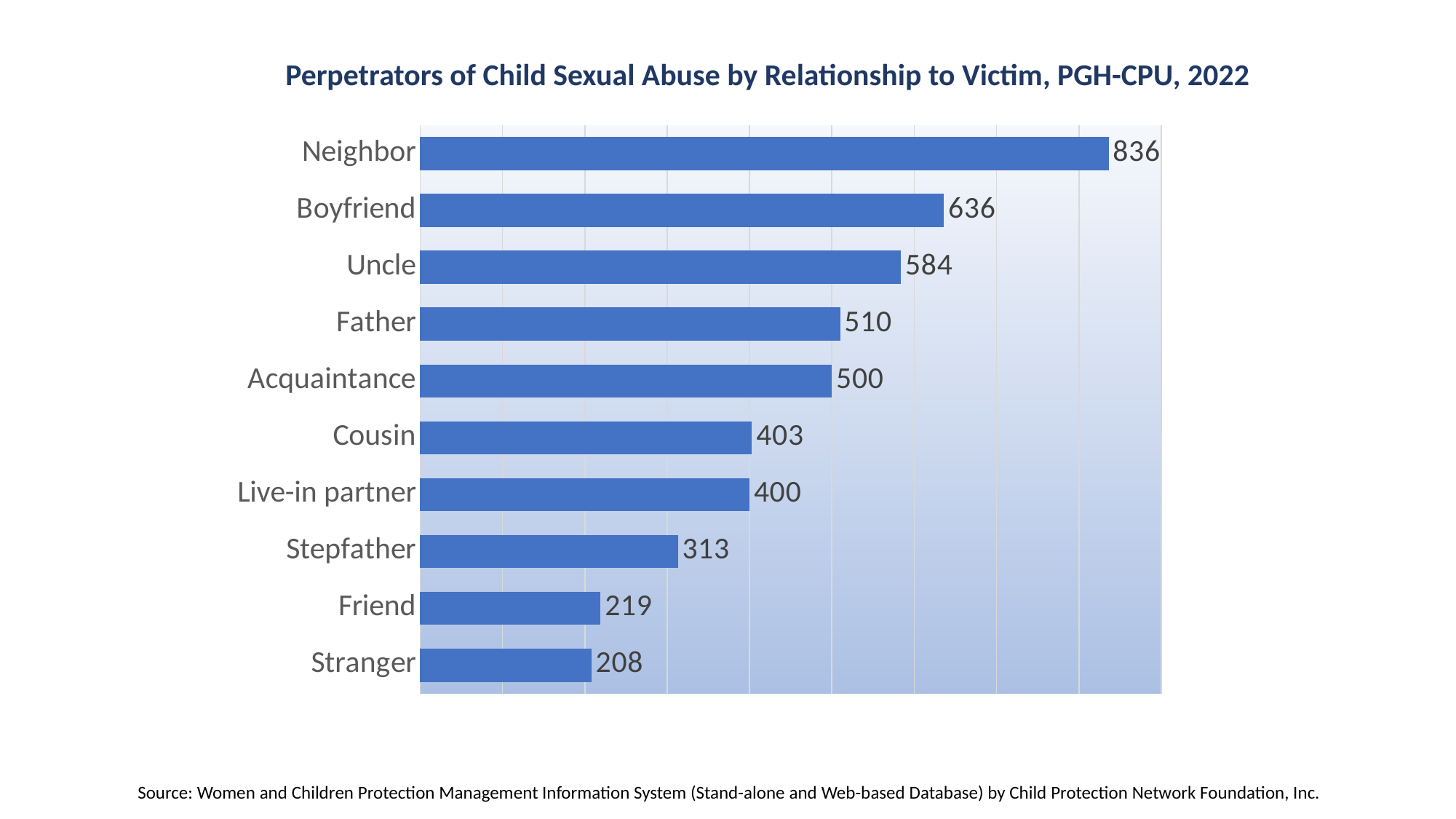
What is the difference between the values for Neighbor and Boyfriend? 200 Which category has the lowest value? Stranger Which is larger, the value for Uncle or the value for Father? Uncle What is the value for Neighbor? 836 Which is larger, the value for Stepfather or the value for Cousin? Cousin How many categories are shown in the chart? 10 What is the title of the chart? Perpetrators of Child Sexual Abuse by Relationship to Victim, PGH-CPU, 2022 What is the value for Stepfather? 313 What kind of chart is shown on the slide? Bar chart Which category has the highest value? Neighbor What is the difference between the values for Friend and Stranger? 11 What is the value for Acquaintance? 500